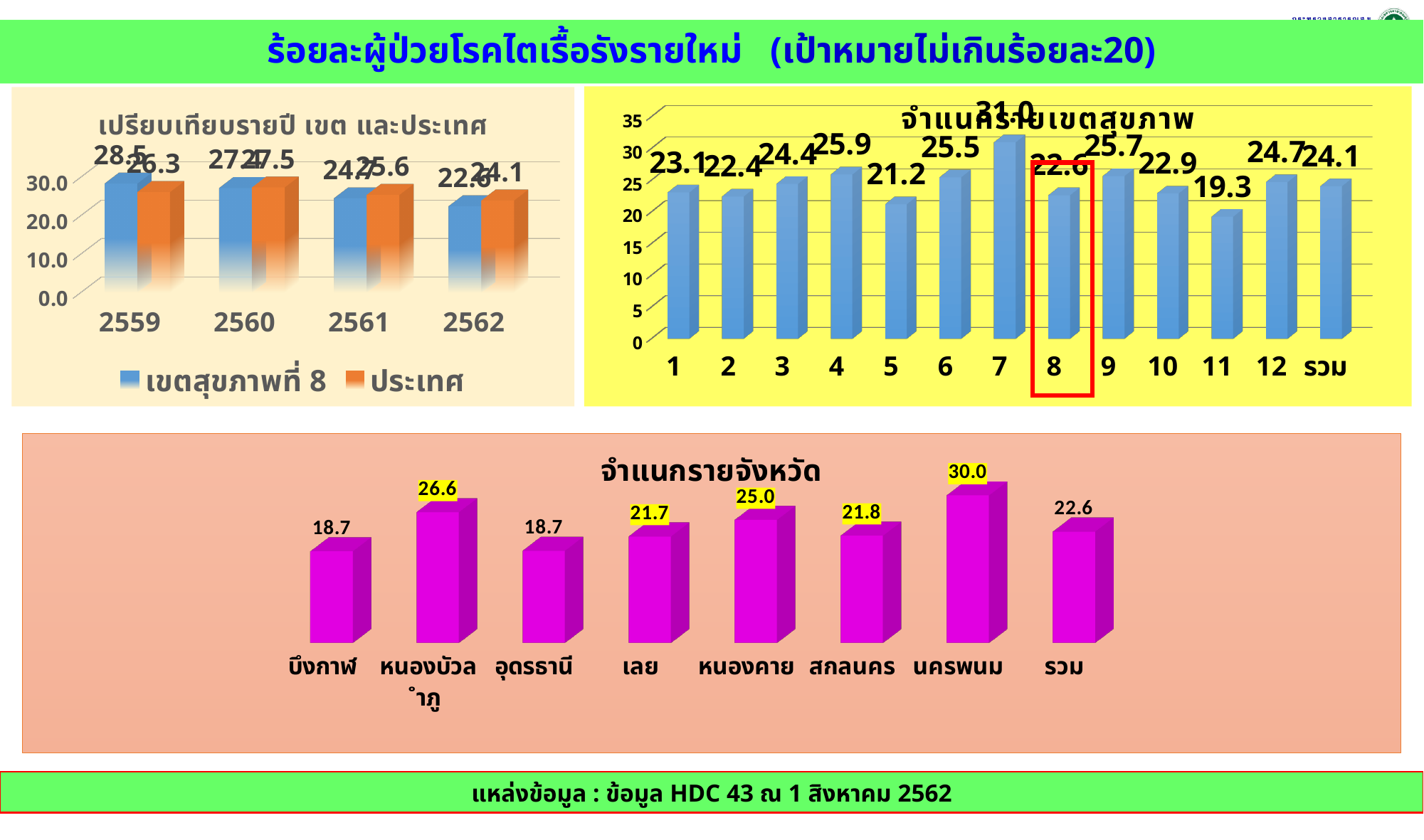
In the top-left chart titled เปรียบเทียบรายปี เขต และประเทศ, what is the value for เขตสุขภาพที่ 8 in 2559? 28.5 In the top-left chart titled เปรียบเทียบรายปี เขต และประเทศ, what is the difference between ประเทศ and เขตสุขภาพที่ 8 in 2562? 1.5 In the bottom chart titled จำแนกรายจังหวัด, which province has the highest value? นครพนม In the top-left chart titled เปรียบเทียบรายปี เขต และประเทศ, how many series does the legend list? 2 In the top-right chart titled จำแนกรายเขตสุขภาพ, how many categories are shown on the x axis? 13 In the top-right chart titled จำแนกรายเขตสุขภาพ, which category has the lowest value? 11 In the top-right chart titled จำแนกรายเขตสุขภาพ, what is the value for category 8? 22.6 In the bottom chart titled จำแนกรายจังหวัด, what is the value for นครพนม? 30.0 In the bottom chart titled จำแนกรายจังหวัด, which is larger, หนองคาย or สกลนคร? หนองคาย In the bottom chart titled จำแนกรายจังหวัด, how many bars are plotted? 8 In the top-right chart titled จำแนกรายเขตสุขภาพ, which category has the highest value? 7 In the bottom chart titled จำแนกรายจังหวัด, what is the difference between หนองบัวลำภู and เลย? 4.9